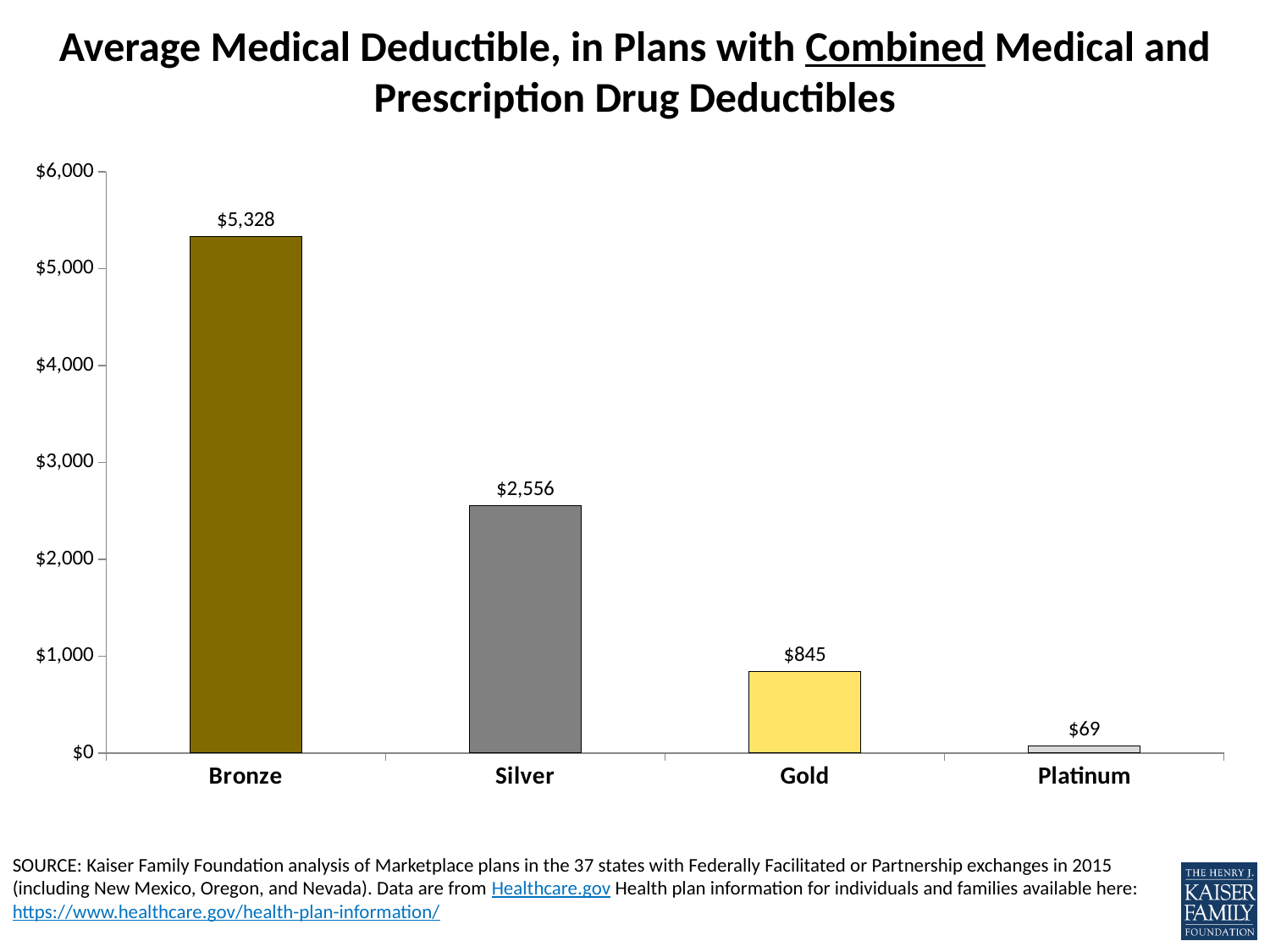
What kind of chart is shown on the slide? Bar chart What is the average medical deductible for Silver plans? $2,556 How many plan types are shown on the chart? 4 Which has a larger average medical deductible, Silver or Gold? Silver What is the difference between the Gold and Platinum average medical deductibles? $776 What is the average medical deductible for Platinum plans? $69 Which plan type has the lowest average medical deductible? Platinum Which plan type has the highest average medical deductible? Bronze Is the value for Silver greater or less than $3,000? less What is the average medical deductible for Bronze plans? $5,328 What is the difference between the Bronze and Silver average medical deductibles? $2,772 What is the average medical deductible for Gold plans? $845